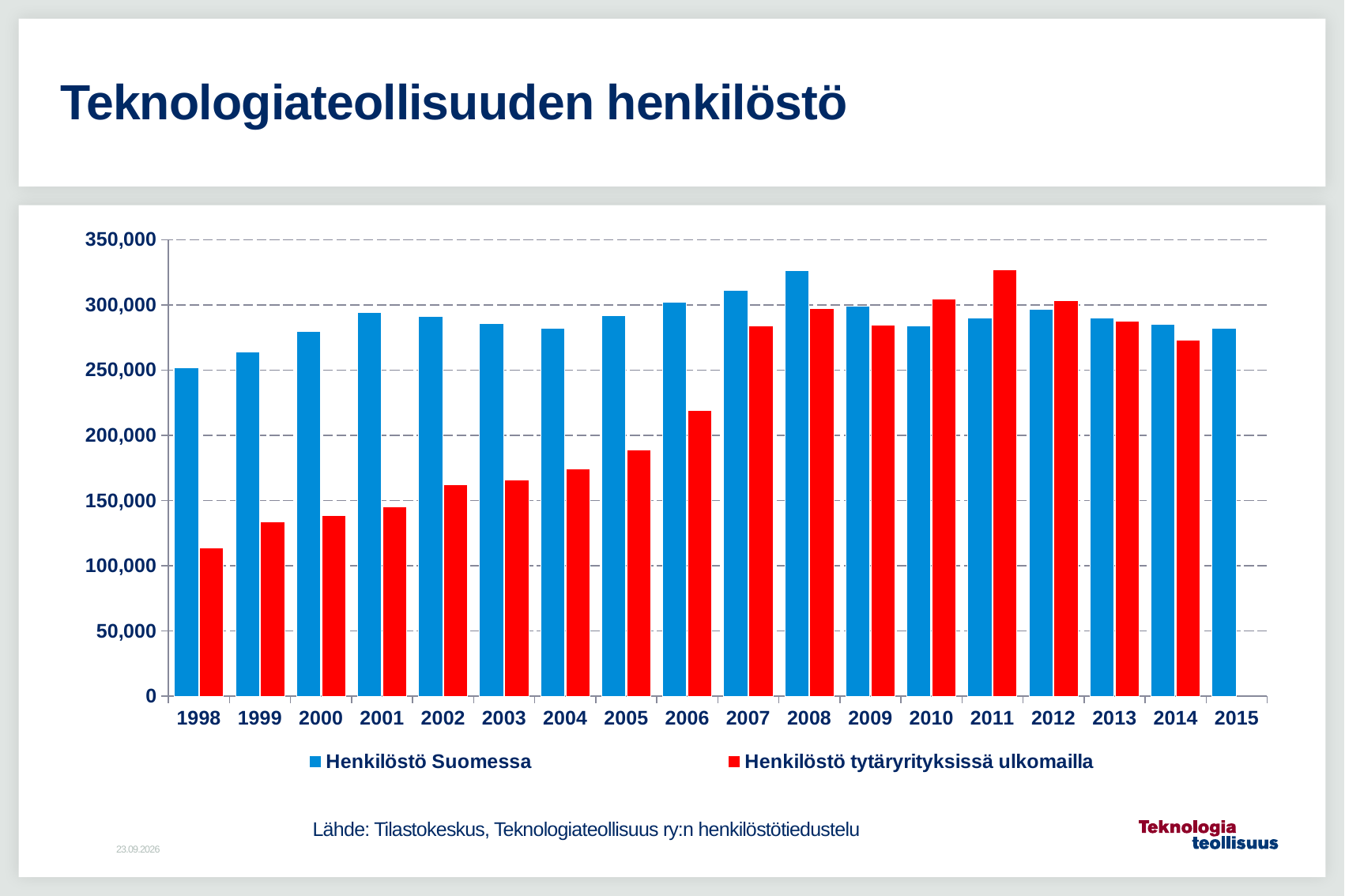
In which year is the value for Henkilöstö Suomessa highest? 2008 In which year is the value for Henkilöstö tytäryrityksissä ulkomailla lowest? 1998 In 2011, which series has the larger value, Henkilöstö Suomessa or Henkilöstö tytäryrityksissä ulkomailla? Henkilöstö tytäryrityksissä ulkomailla Do the values for Henkilöstö tytäryrityksissä ulkomailla rise or fall from 1998 to 2011? rise In 2006, which series has the larger value, Henkilöstö Suomessa or Henkilöstö tytäryrityksissä ulkomailla? Henkilöstö Suomessa How many years are shown on the x axis? 18 Is the value for Henkilöstö tytäryrityksissä ulkomailla in 1998 greater or less than 150,000? less Is the value for Henkilöstö Suomessa in 2008 greater or less than 300,000? greater In which year is the value for Henkilöstö tytäryrityksissä ulkomailla highest? 2011 What kind of chart is shown on the slide? bar chart How many series does the legend list? 2 Is the value for Henkilöstö tytäryrityksissä ulkomailla in 2011 greater or less than 300,000? greater